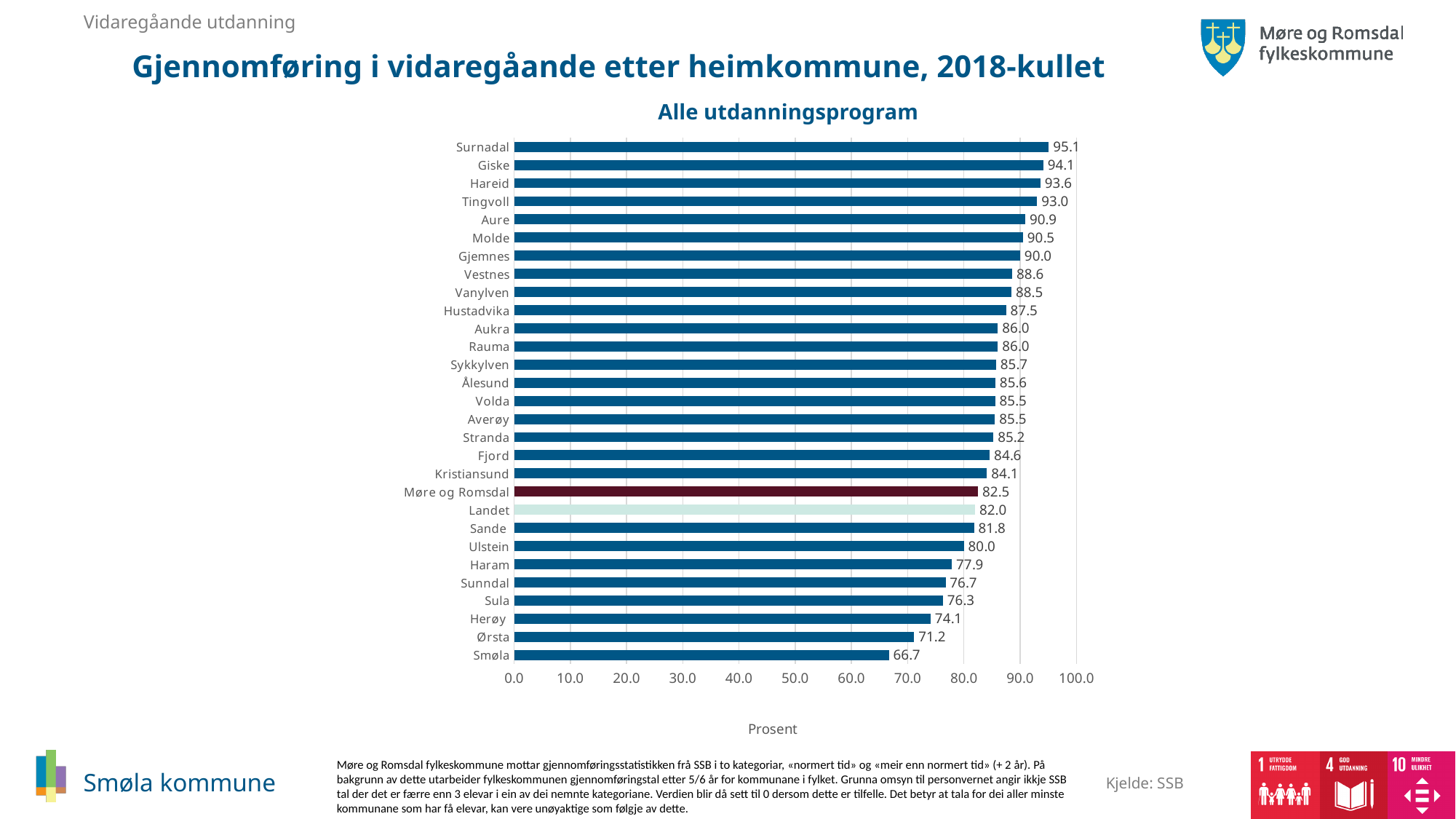
Which has a larger value, Ørsta or Herøy? Herøy What kind of chart is shown on the slide? Bar chart How many categories are shown on the chart? 29 What is the difference between the values for Møre og Romsdal and Landet? 0.5 What is the value for Landet? 82.0 Which category has the highest value? Surnadal Which category has the lowest value? Smøla What is the difference between the values for Surnadal and Smøla? 28.4 What is the value for Molde? 90.5 What is the value for Smøla? 66.7 What is the value for Møre og Romsdal? 82.5 What is the title of the chart? Alle utdanningsprogram